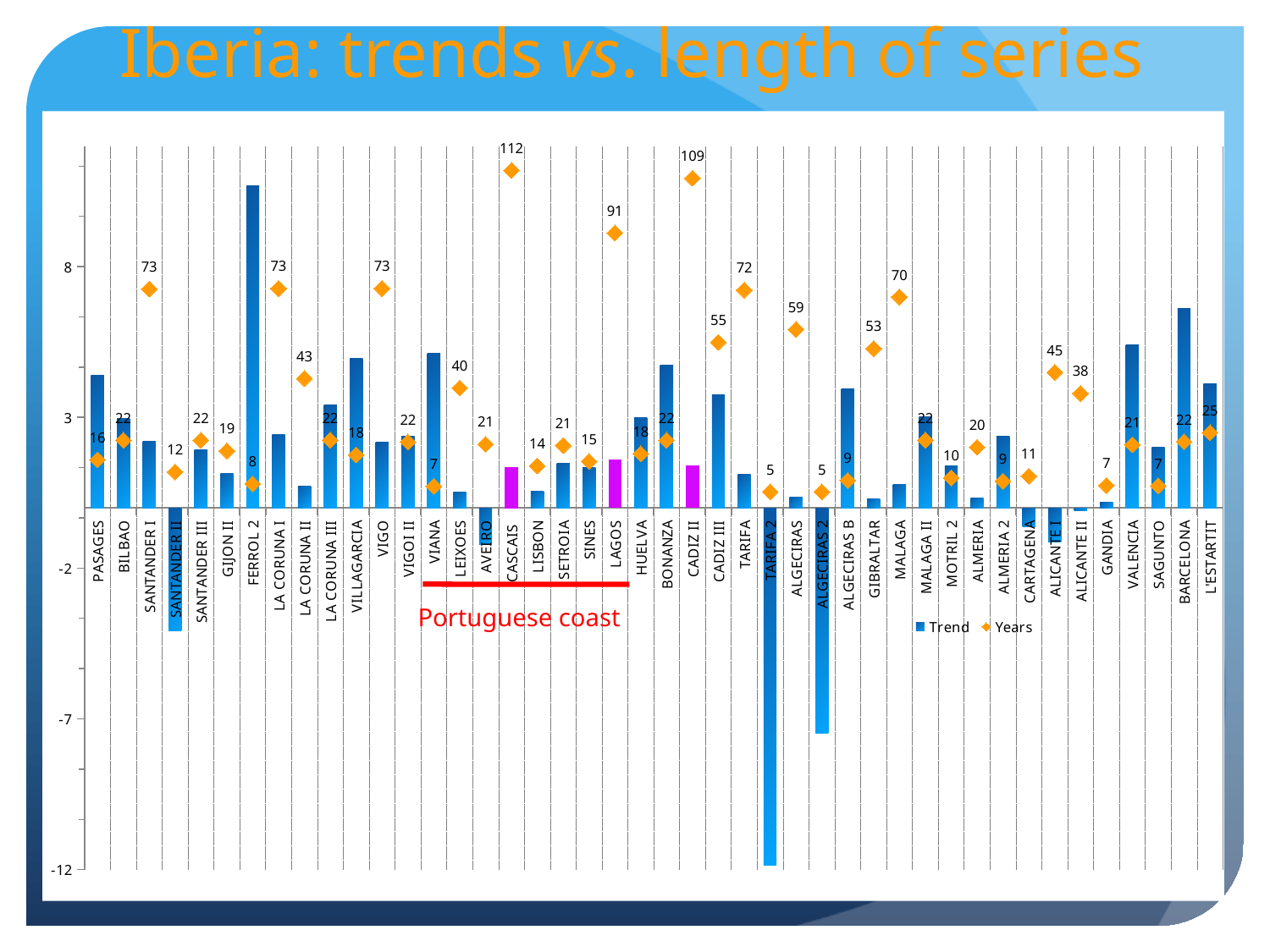
Which station has the highest Years value? CASCAIS Which has a larger Years value, LAGOS or TARIFA? LAGOS What is the difference between the Years values for CASCAIS and CADIZ II? 3 What is the Years value for LA CORUNA II? 43 Is the Trend value for FERROL 2 greater or less than 8? greater What kind of chart is shown on the slide? Bar chart with a marker series Is the Trend value for TARIFA 2 greater or less than -7? less What is the Years value for CADIZ II? 109 What is the title of the slide? Iberia: trends vs. length of series What label is written under the red line beneath the chart? Portuguese coast How many series does the legend list? 2 What is the Years value for CASCAIS? 112